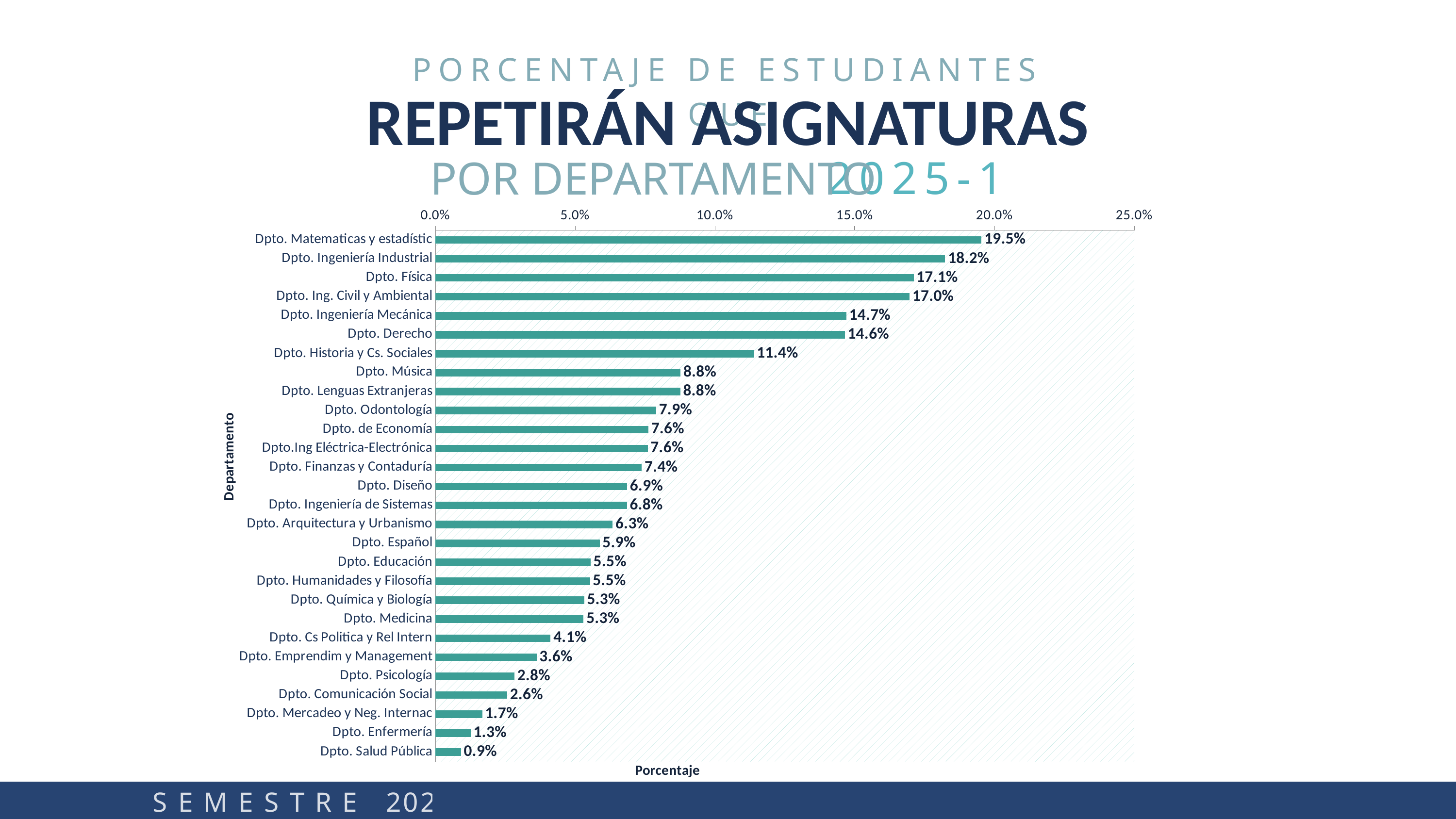
What kind of chart is shown on the slide? bar chart Is the value for Dpto. Odontología greater or less than 10.0%? less How many departments are shown in the chart? 28 Which is larger, the value for Dpto. Historia y Cs. Sociales or the value for Dpto. Música? Dpto. Historia y Cs. Sociales What is the label of the vertical axis? Departamento What is the label of the horizontal axis? Porcentaje Which department has the highest percentage? Dpto. Matematicas y estadístic What is the difference between the values for Dpto. Ingeniería Industrial and Dpto. Ingeniería Mecánica? 3.5% What is the value for Dpto. Física? 17.1% What is the value for Dpto. Derecho? 14.6% What is the value for Dpto. Psicología? 2.8% Which department has the lowest percentage? Dpto. Salud Pública